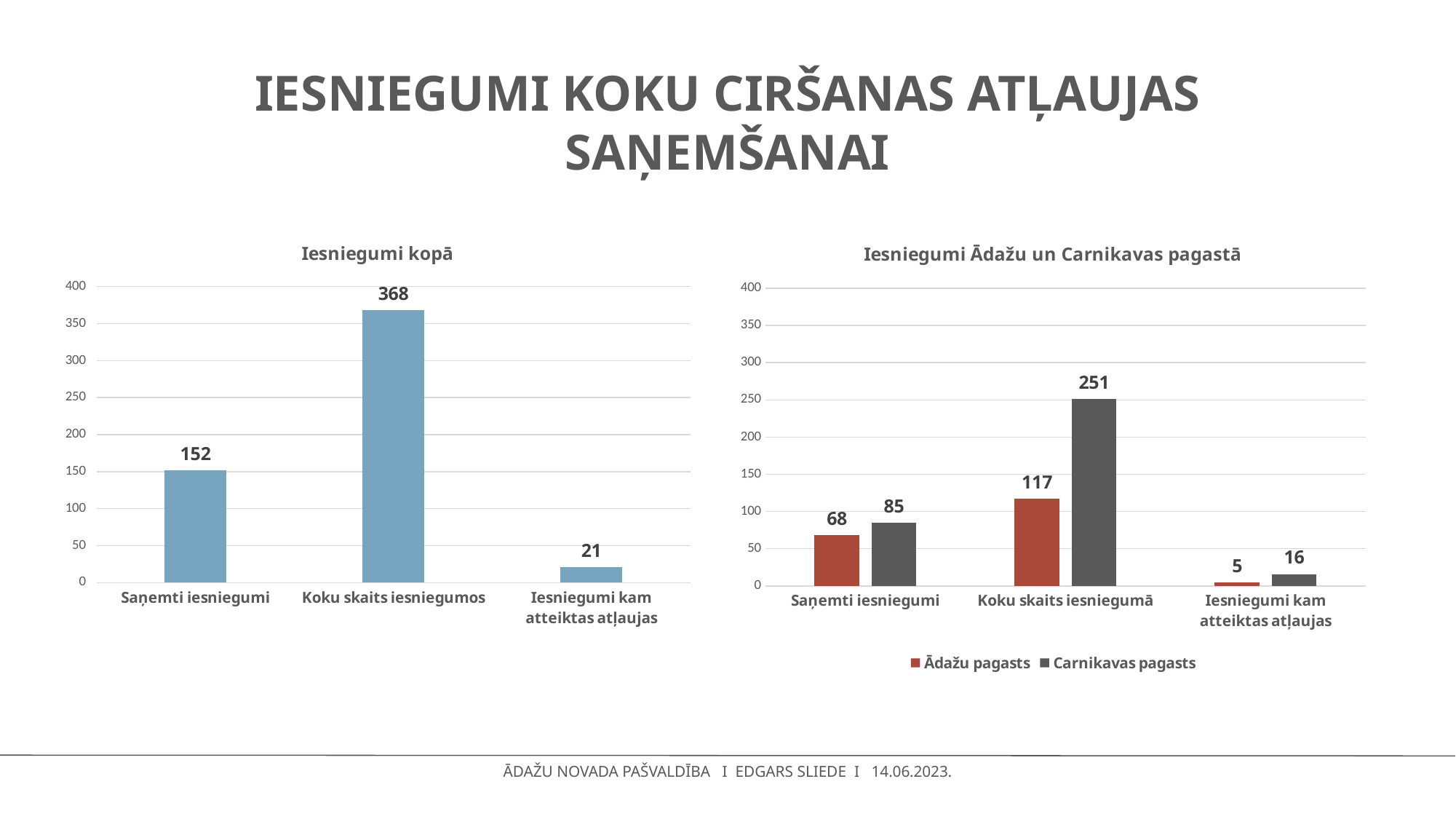
In the chart 'Iesniegumi Ādažu un Carnikavas pagastā', what is the value for Ādažu pagasts in 'Iesniegumi kam atteiktas atļaujas'? 5 In the chart 'Iesniegumi Ādažu un Carnikavas pagastā', which category has the highest value for Ādažu pagasts? Koku skaits iesniegumā In the chart 'Iesniegumi Ādažu un Carnikavas pagastā', what is the difference between Carnikavas pagasts and Ādažu pagasts for 'Koku skaits iesniegumā'? 134 In the chart 'Iesniegumi Ādažu un Carnikavas pagastā', which is larger for 'Saņemti iesniegumi': Ādažu pagasts or Carnikavas pagasts? Carnikavas pagasts What kind of chart is 'Iesniegumi kopā'? bar chart In the chart 'Iesniegumi kopā', how many categories are shown? 3 In the chart 'Iesniegumi Ādažu un Carnikavas pagastā', how many series does the legend list? 2 In the chart 'Iesniegumi kopā', what is the value for 'Koku skaits iesniegumos'? 368 In the chart 'Iesniegumi Ādažu un Carnikavas pagastā', which series is shown in red? Ādažu pagasts In the chart 'Iesniegumi Ādažu un Carnikavas pagastā', what is the value for Carnikavas pagasts in 'Koku skaits iesniegumā'? 251 In the chart 'Iesniegumi kopā', what is the difference between 'Koku skaits iesniegumos' and 'Saņemti iesniegumi'? 216 In the chart 'Iesniegumi kopā', which category has the lowest value? Iesniegumi kam atteiktas atļaujas